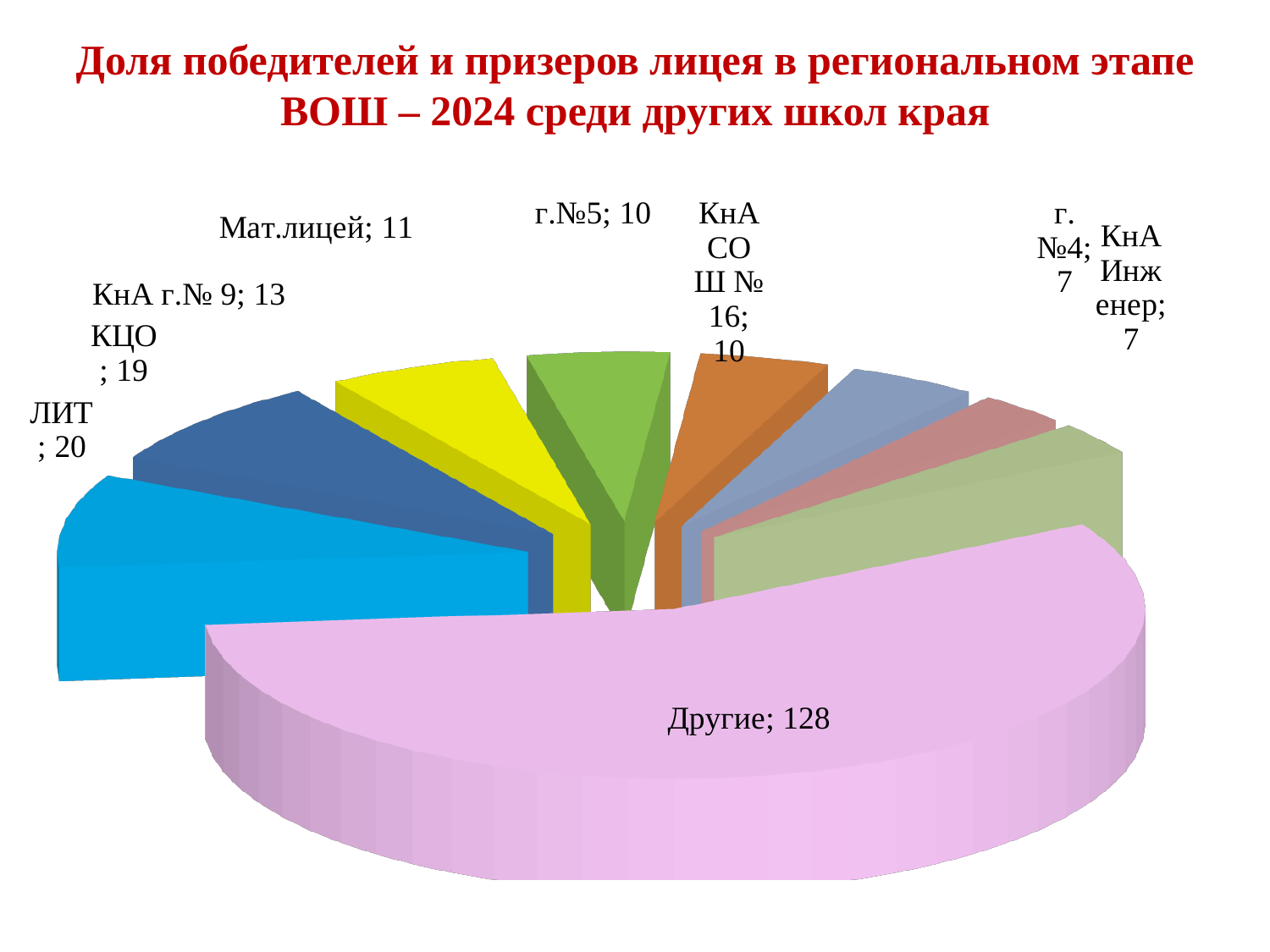
Which has the larger value, ЛИТ or КЦО? ЛИТ What value is shown for the Другие slice? 128 What is the total of all the slice values in the pie chart? 225 What kind of chart is shown on the slide? Pie chart What value is shown for Мат.лицей? 11 What value is shown for the КЦО slice? 19 How many slices does the pie chart have? 9 Which slice has the largest value? Другие What is the difference between the values for Другие and ЛИТ? 108 What value is shown for КнА г.№ 9? 13 What value is shown for the ЛИТ slice? 20 Which two slices share the smallest value of 7? г.№4 and КнА Инженер